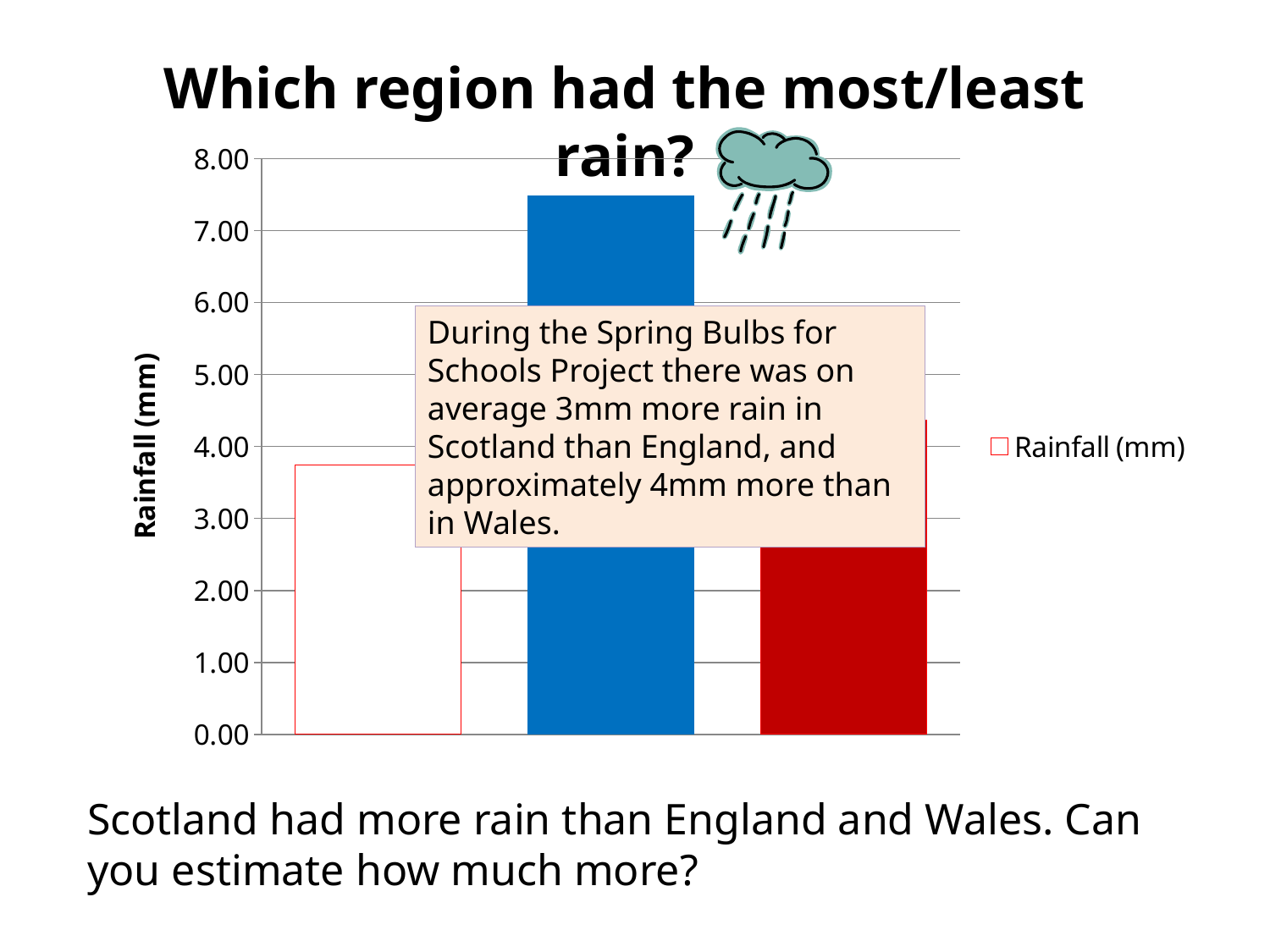
Which is larger: the red bar on the right or the white bar on the left? the red bar on the right What is the label on the vertical axis of the chart? Rainfall (mm) What kind of chart is shown on the slide? bar chart Is the value of the white left bar greater or less than 3.00? greater Is the value of the blue middle bar greater or less than 7.00? greater Which bar is the tallest in the chart: the white bar on the left, the blue bar in the middle, or the red bar on the right? the blue bar in the middle Is the value of the red right bar greater or less than 4.00? greater Which bar is the shortest in the chart: the white bar on the left, the blue bar in the middle, or the red bar on the right? the white bar on the left What is the series name shown in the chart legend? Rainfall (mm) How many bars are plotted in the chart? 3 How many series does the chart legend list? 1